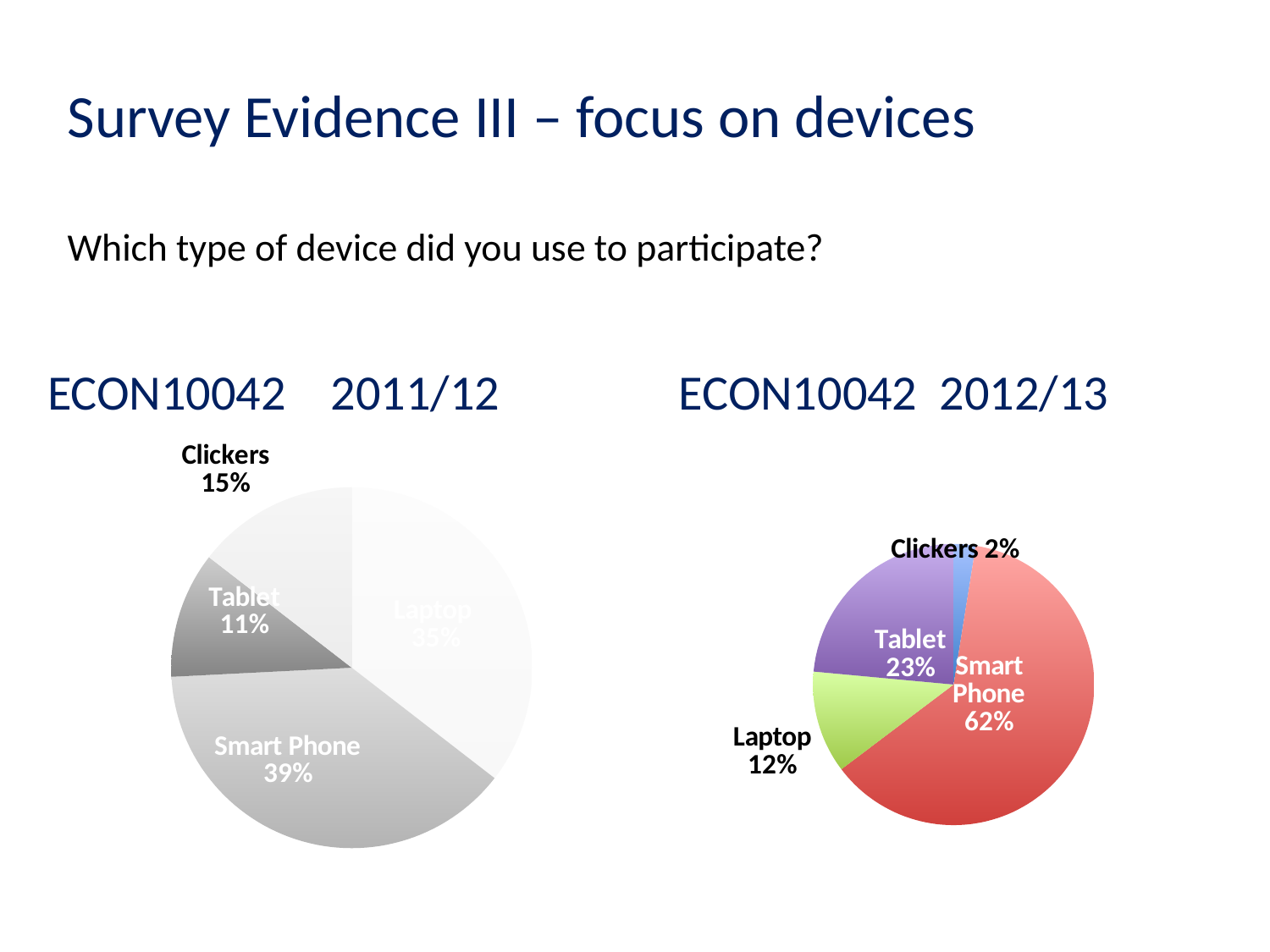
What kind of chart is used for ECON10042 2011/12? Pie chart In the ECON10042 2012/13 chart, which device has the smallest share? Clickers In the ECON10042 2012/13 chart, what share of respondents used a Smart Phone? 62% In the ECON10042 2011/12 chart, which device has the smallest share? Tablet How many device categories are shown in the ECON10042 2012/13 pie chart? 4 In the ECON10042 2011/12 chart, what share of respondents used a Tablet? 11% Which is larger in the ECON10042 2012/13 chart: the Tablet share or the Laptop share? Tablet In the ECON10042 2012/13 chart, what is the difference between the Smart Phone share and the Laptop share? 50% In the ECON10042 2011/12 chart, what is the difference between the Clickers share and the Tablet share? 4% In the ECON10042 2011/12 chart, what share of respondents used Clickers? 15% In the ECON10042 2012/13 chart, which device has the largest share? Smart Phone In the ECON10042 2012/13 chart, what share of respondents used a Tablet? 23%